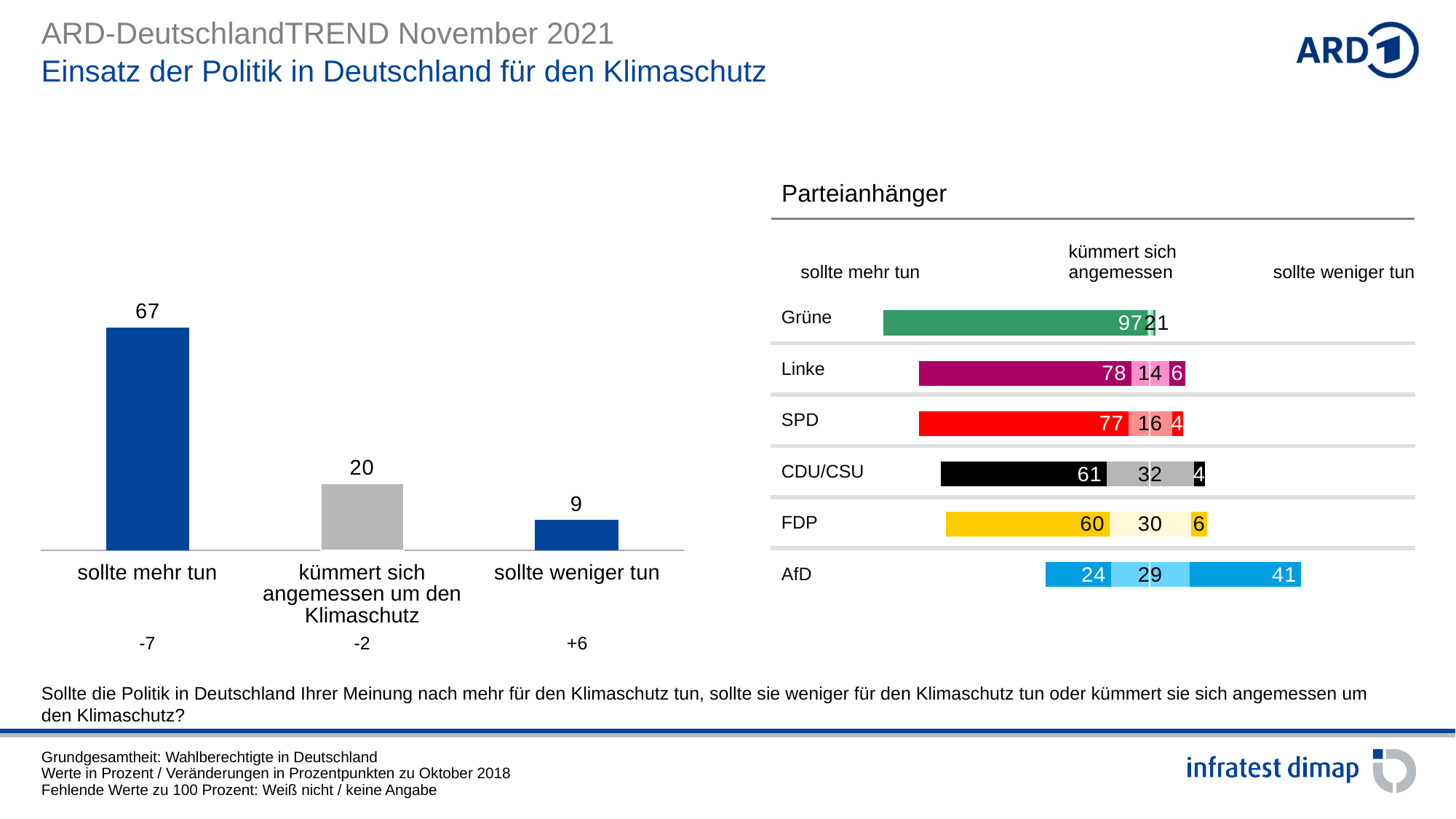
In the left bar chart, what change in percentage points compared to October 2018 is shown under "sollte weniger tun"? +6 In the left bar chart, which category has the lowest value? sollte weniger tun In the Parteianhänger chart, what is the "sollte weniger tun" value for AfD? 41 In the left bar chart, what is the value for "sollte mehr tun"? 67 What kind of chart is the Parteianhänger chart? Stacked bar chart In the left bar chart, what is the difference between "sollte mehr tun" and "kümmert sich angemessen um den Klimaschutz"? 47 In the Parteianhänger chart, which party has the highest "sollte mehr tun" value? Grüne In the Parteianhänger chart, what is the "kümmert sich angemessen" value for CDU/CSU? 32 In the left bar chart, what is the value for "sollte weniger tun"? 9 In the Parteianhänger chart, what is the "sollte mehr tun" value for Linke? 78 In the Parteianhänger chart, which is larger: the "sollte mehr tun" value for FDP or for SPD? SPD In the left bar chart, how many categories are shown? 3